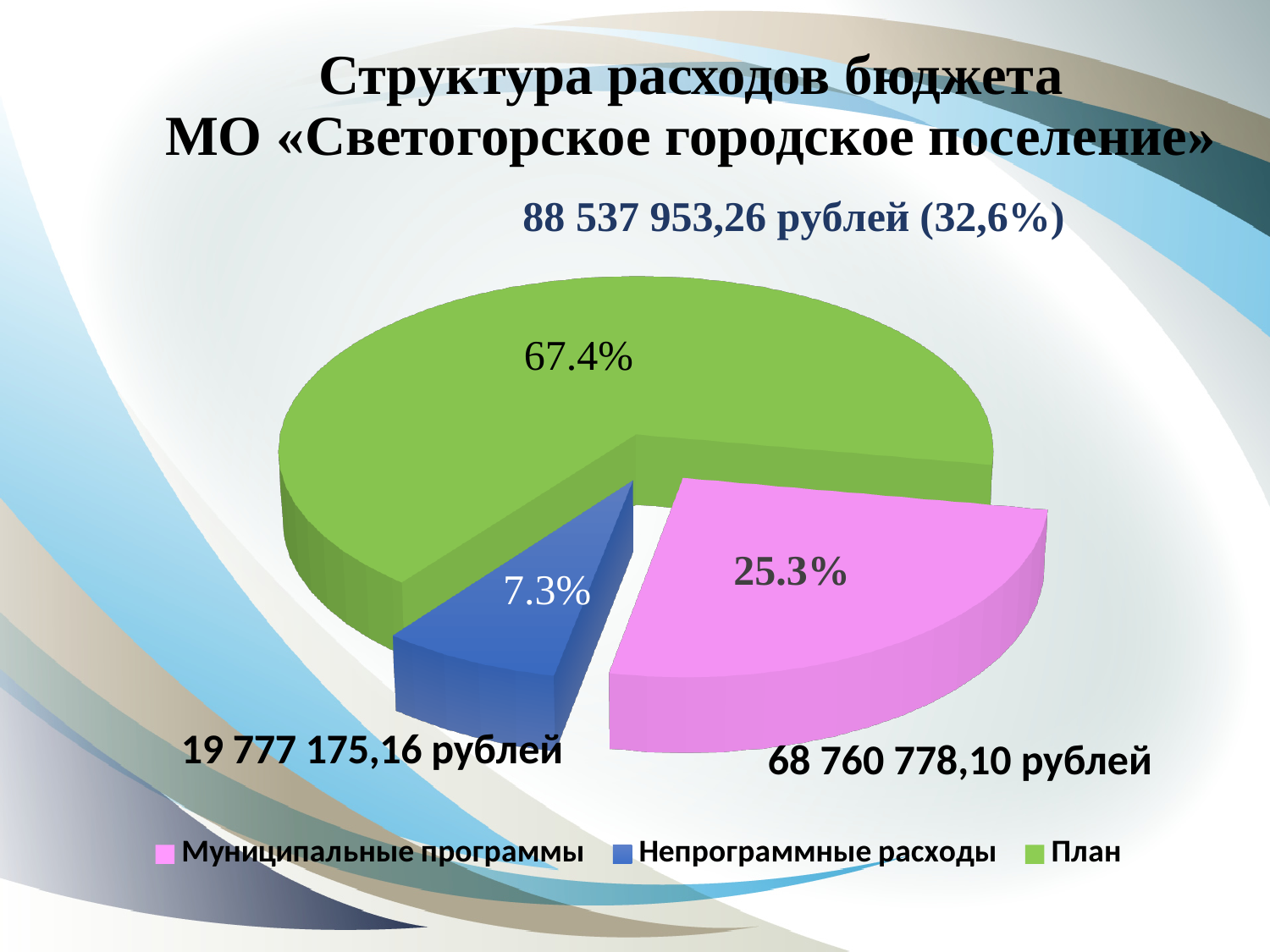
Which slice is larger: Муниципальные программы or Непрограммные расходы? Муниципальные программы Which category has the largest slice of the pie? План Which category has the smallest slice of the pie? Непрограммные расходы What is the difference in percentage points between the План slice and the Муниципальные программы slice? 42.1 How many entries does the legend list? 3 What share of the pie does the План slice represent? 67.4% What share of the pie does the Непрограммные расходы slice represent? 7.3% What colour is the Непрограммные расходы slice in the pie chart? Blue How many slices does the pie chart have? 3 What share of the pie does the Муниципальные программы slice represent? 25.3% What type of chart is shown on the slide? Pie chart What is the difference in percentage points between the Муниципальные программы slice and the Непрограммные расходы slice? 18.0